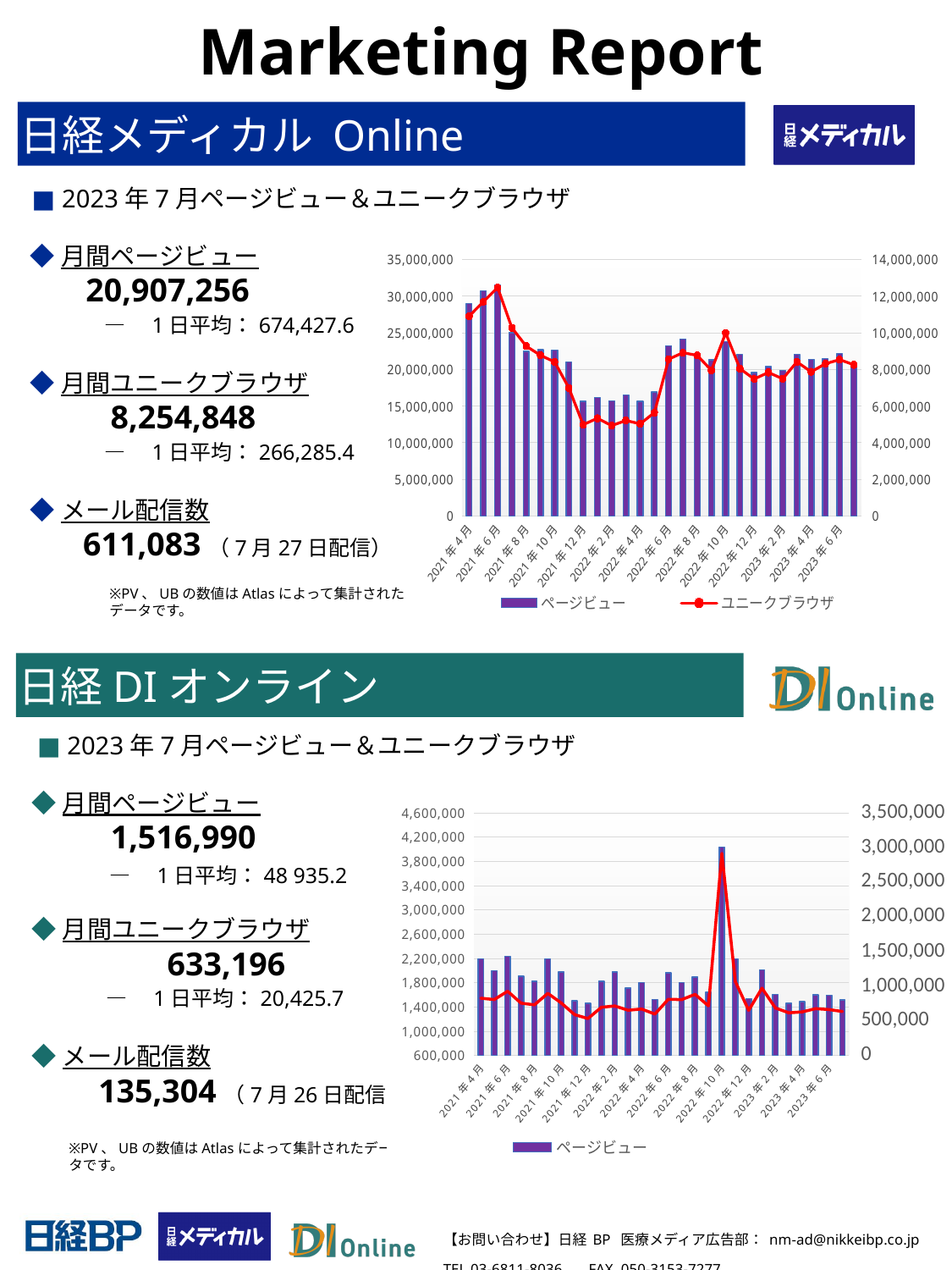
In the 日経メディカル Online chart, is the ページビュー value for 2022年2月 greater or less than 20,000,000? less In the 日経メディカル Online chart, which month has the highest ユニークブラウザ value? 2021年6月 How many series does the legend of the 日経DIオンライン chart list? 1 How many month labels are shown on the x axis of the 日経メディカル Online chart? 14 In the 日経DIオンライン chart, is the ページビュー value for 2023年6月 greater or less than 1,800,000? less In the 日経メディカル Online chart, do the ページビュー bars rise or fall from 2021年6月 to 2021年12月? fall In the 日経メディカル Online chart, is the ユニークブラウザ value for 2021年12月 greater or less than 8,000,000? less How many series does the legend of the 日経メディカル Online chart list? 2 What is the maximum value shown on the right-hand axis of the 日経メディカル Online chart? 14,000,000 What kind of chart is shown in the 日経メディカル Online section? A combined bar and line chart